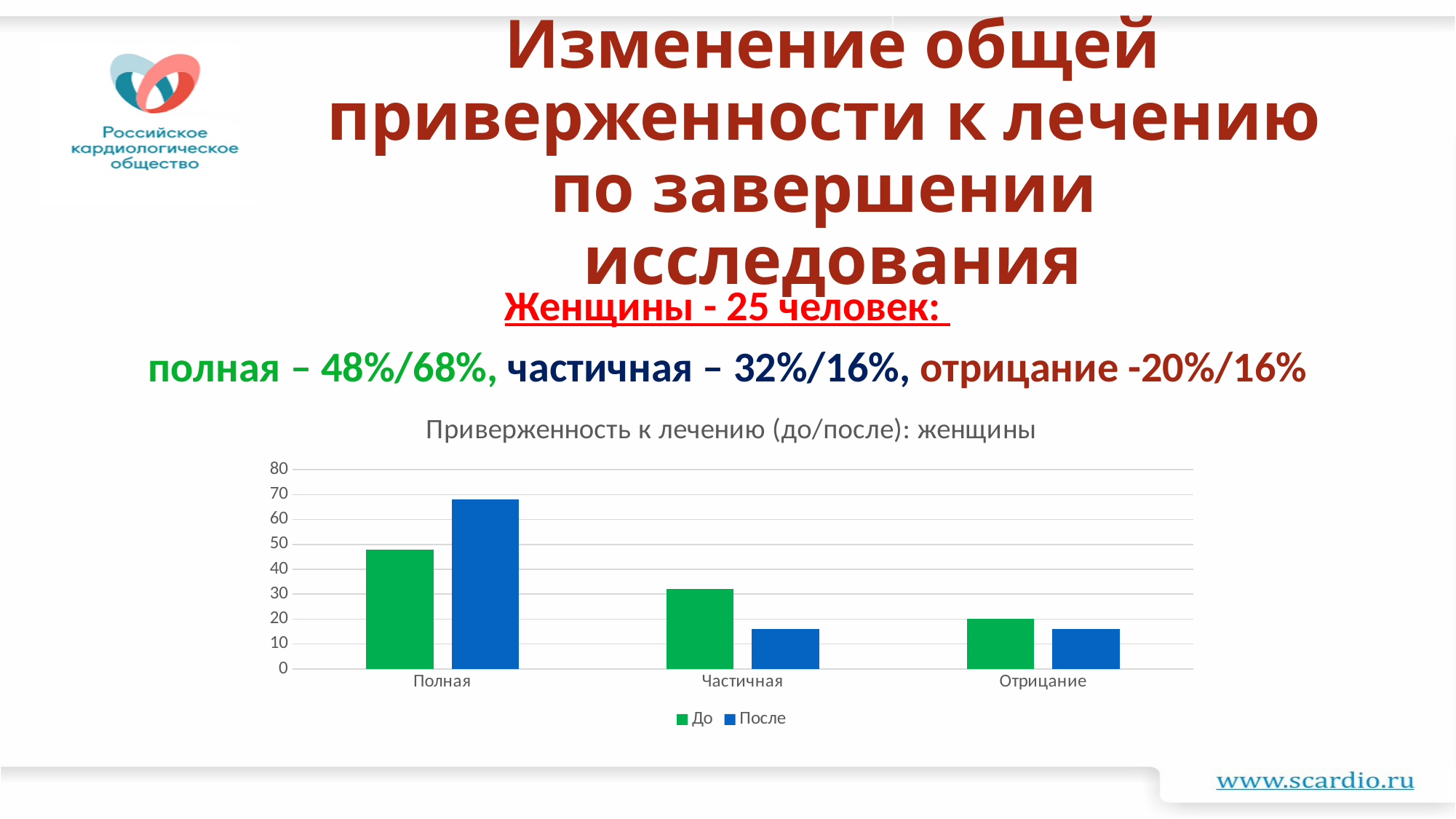
How many series does the chart legend list? 2 What is the value of the 'После' series for the 'Полная' category? 68% For the 'Частичная' category, which is larger: the 'До' value or the 'После' value? До What is the value of the 'До' series for the 'Полная' category? 48% What is the difference between the 'После' and 'До' values for the 'Полная' category? 20% Which category has the highest 'После' value? Полная What is the value of the 'После' series for the 'Отрицание' category? 16% What is the value of the 'До' series for the 'Частичная' category? 32% Which category has the lowest 'До' value? Отрицание How many categories are shown on the x axis of the chart? 3 What kind of chart is shown on the slide? bar chart What is the title of the chart? Приверженность к лечению (до/после): женщины